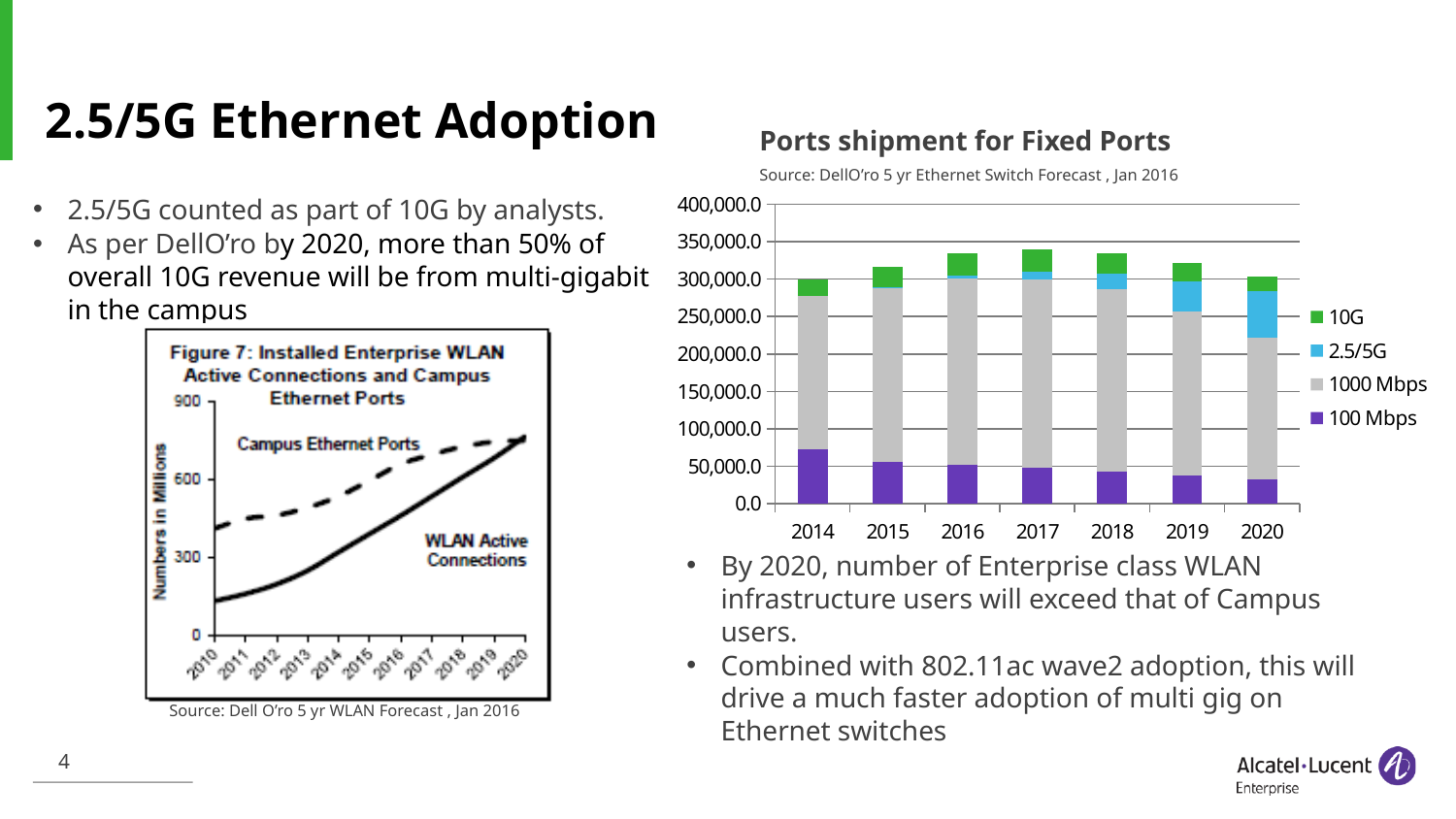
In the 'Ports shipment for Fixed Ports' chart, is the total bar height for 2017 greater or less than 300,000? greater In the Figure 7 line chart, which is larger in 2010: Campus Ethernet Ports or WLAN Active Connections? Campus Ethernet Ports How many series does the legend of the 'Ports shipment for Fixed Ports' chart list? 4 In the 'Ports shipment for Fixed Ports' chart, does the 100 Mbps segment rise or fall from 2014 to 2020? Fall In the 'Ports shipment for Fixed Ports' chart, which colour represents 1000 Mbps? Grey What kind of chart is the 'Ports shipment for Fixed Ports' chart? Stacked bar chart How many years are shown on the x axis of the 'Ports shipment for Fixed Ports' chart? 7 In the Figure 7 line chart, is the WLAN Active Connections value for 2010 greater or less than 300? less In the 'Ports shipment for Fixed Ports' chart, does the 2.5/5G segment rise or fall from 2014 to 2020? Rise What kind of chart is 'Figure 7: Installed Enterprise WLAN Active Connections and Campus Ethernet Ports'? Line chart In the 'Ports shipment for Fixed Ports' chart, is the 100 Mbps value for 2020 greater or less than 50,000? less